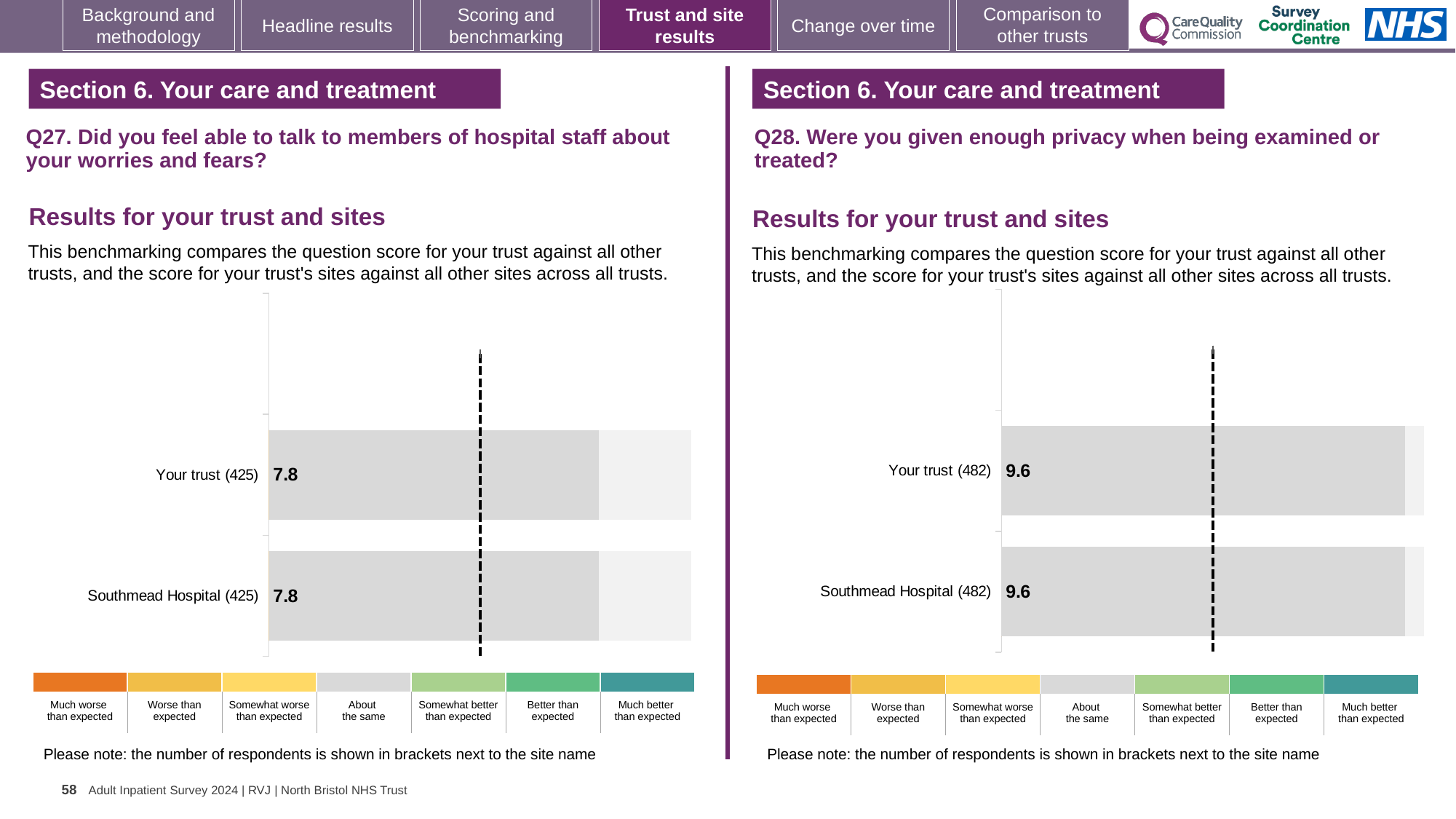
How many bars are plotted in the Q28 chart on the right? 2 In the Q28 chart on the right, what is the score for Your trust? 9.6 How many bars are plotted in the Q27 chart on the left? 2 What kind of chart is used for the Q28 results on the right? Bar chart In the Q27 chart on the left, what is the score for Southmead Hospital? 7.8 In the Q27 chart on the left, what is the score for Your trust? 7.8 Is the Your trust score in the Q28 chart on the right larger than the Your trust score in the Q27 chart on the left? Yes In the Q28 chart on the right, what is the difference between the score for Your trust and the score for Southmead Hospital? 0 In the Q27 chart on the left, what is the difference between the score for Your trust and the score for Southmead Hospital? 0 How many benchmark categories does the colour key below the Q28 chart on the right list? 7 In the Q27 chart on the left, how many respondents are shown in brackets next to Southmead Hospital? 425 In the Q28 chart on the right, what is the score for Southmead Hospital? 9.6